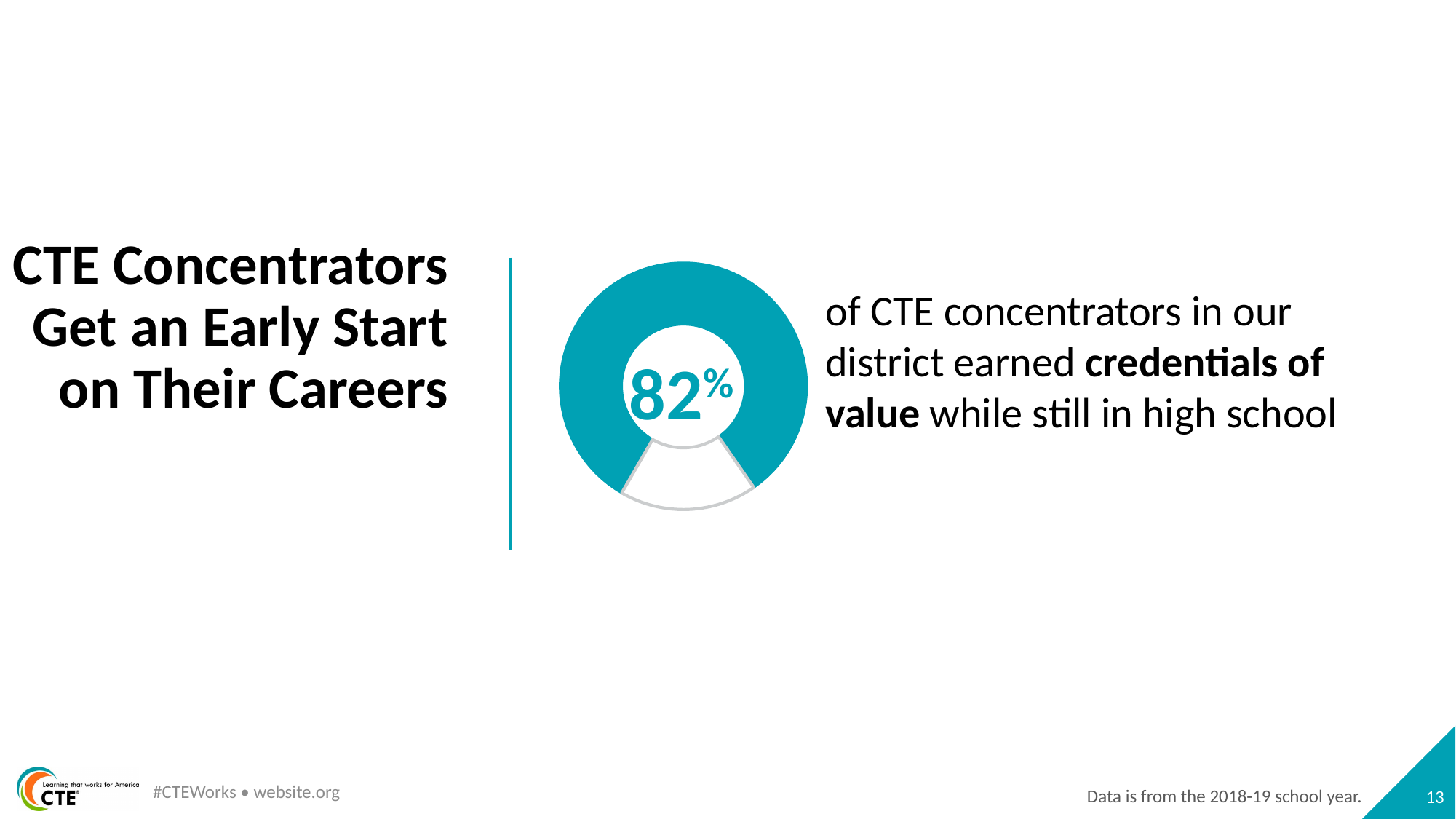
What percentage of CTE concentrators in the district earned credentials of value while still in high school, according to the chart? 82% What colour is the filled portion of the donut chart? Teal What kind of chart is used to show the 82% figure? Donut (pie) chart Is the value shown in the donut chart greater or less than 90%? less Is the value shown in the donut chart greater or less than 50%? greater Which portion of the donut chart is larger, the teal filled portion or the white unfilled portion? The teal filled portion How many segments does the donut chart have? 2 What is the title of the slide containing the donut chart? CTE Concentrators Get an Early Start on Their Careers What share of the donut chart is filled in teal? 82%